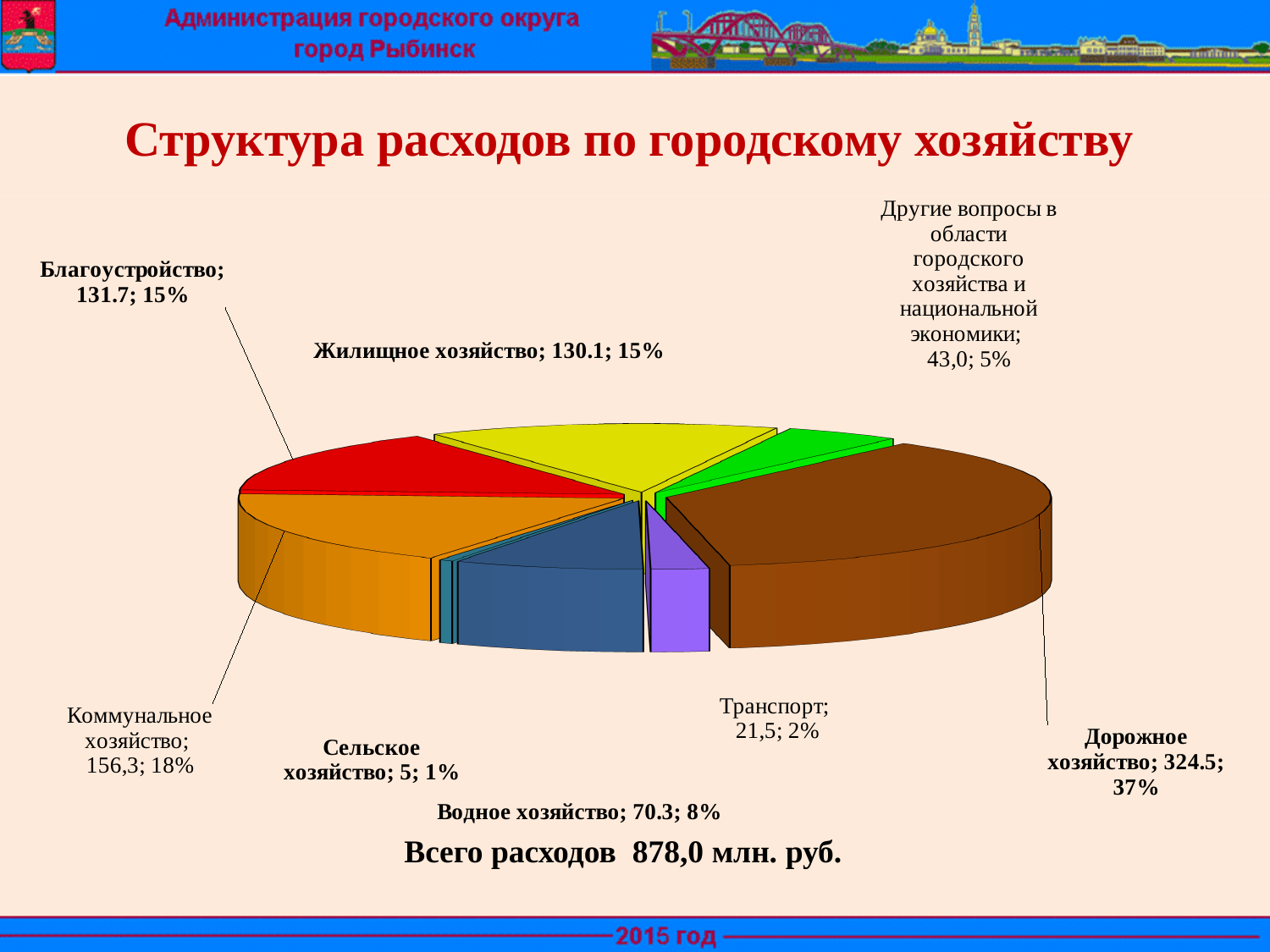
What is the title of the chart? Структура расходов по городскому хозяйству Which is larger, Благоустройство or Жилищное хозяйство? Благоустройство Which category has the smallest share of the pie? Сельское хозяйство What is the share of the pie for Другие вопросы в области городского хозяйства и национальной экономики? 5% How many categories does the pie chart show? 8 What is the value for Водное хозяйство? 70.3 What is the difference between the values for Дорожное хозяйство and Коммунальное хозяйство? 168.2 Which category has the largest share of the pie? Дорожное хозяйство What share of the pie does Коммунальное хозяйство have? 18% What is the value for Дорожное хозяйство? 324.5 What share of the pie does Транспорт have? 2% What kind of chart is shown on the slide? pie chart